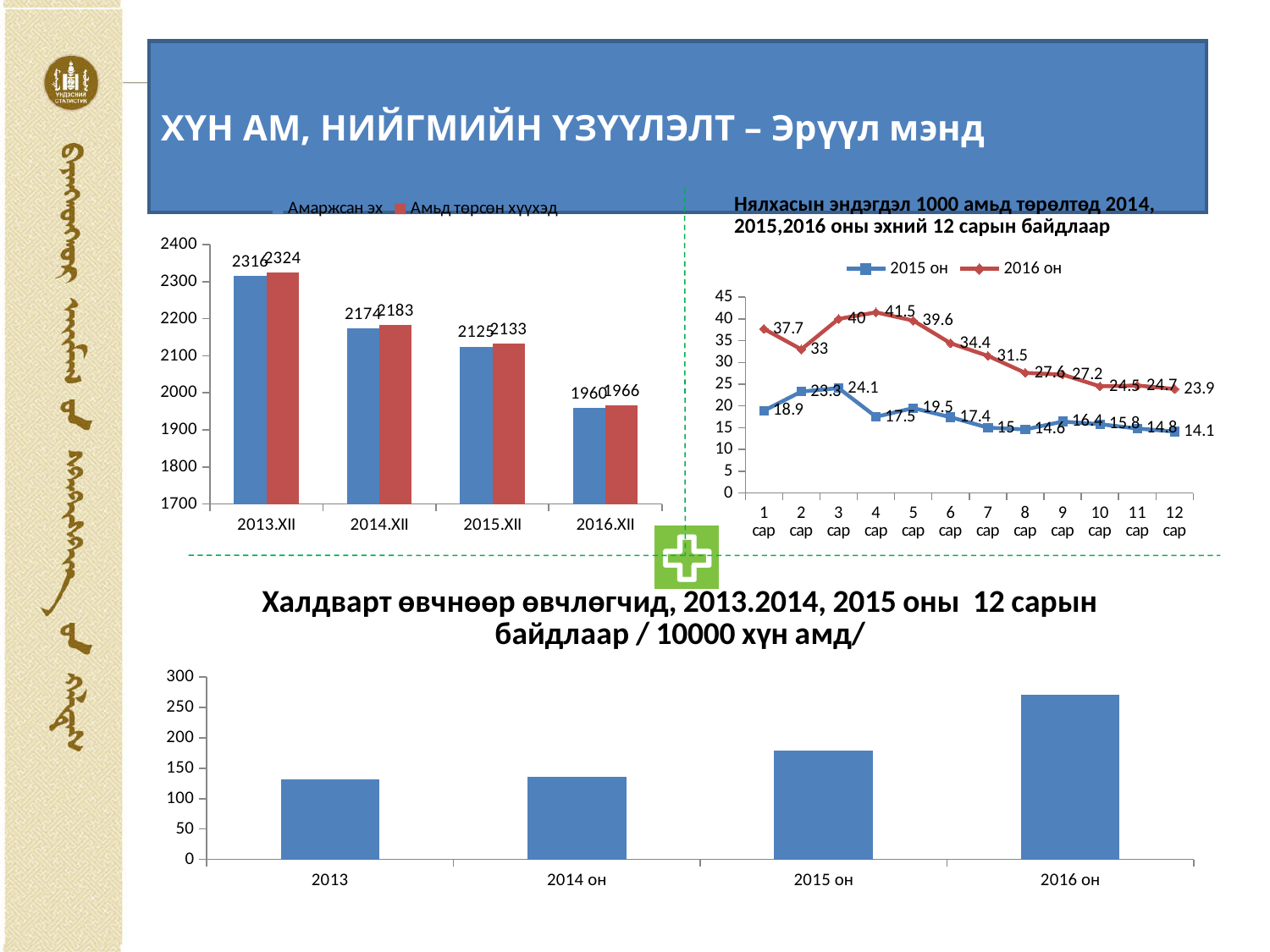
In the chart titled 'Нялхасын эндэгдэл 1000 амьд төрөлтөд...', what is the value for 2016 он in month 4 (4 сар)? 41.5 In the top-left bar chart, what is the value for Амаржсан эх in 2013.XII? 2316 In the chart titled 'Нялхасын эндэгдэл 1000 амьд төрөлтөд...', how many series does the legend list? 2 In the top-left bar chart, which category has the lowest value for Амаржсан эх? 2016.XII In the top-left bar chart, what is the value for Амьд төрсөн хүүхэд in 2016.XII? 1966 In the chart titled 'Нялхасын эндэгдэл 1000 амьд төрөлтөд...', what is the value for 2015 он in month 12 (12 сар)? 14.1 In the top-left bar chart, do the values for Амаржсан эх rise or fall from 2013.XII to 2016.XII? fall In the bottom chart titled 'Халдварт өвчнөөр өвчлөгчид...', is the value for 2016 он greater or less than 250? greater In the chart titled 'Нялхасын эндэгдэл 1000 амьд төрөлтөд...', what is the difference between 2016 он and 2015 он in month 1 (1 сар)? 18.8 What kind of chart is the bottom chart titled 'Халдварт өвчнөөр өвчлөгчид...'? bar chart In the chart titled 'Нялхасын эндэгдэл 1000 амьд төрөлтөд...', which month has the highest value for 2016 он? 4 сар In the top-left bar chart, what is the difference between Амьд төрсөн хүүхэд and Амаржсан эх in 2014.XII? 9